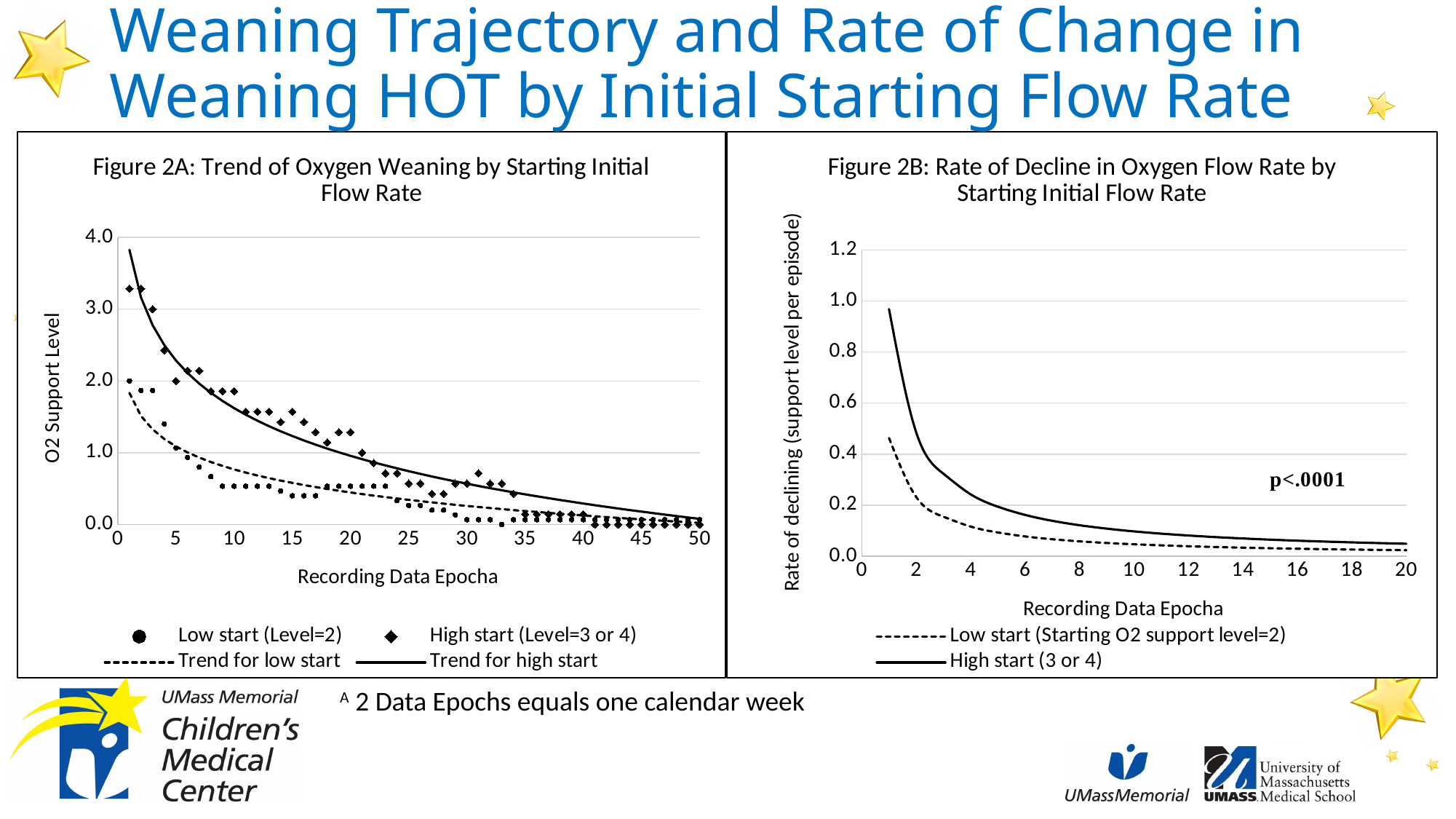
In Figure 2A, do the O2 support level values for the high start group rise or fall as the recording data epoch increases? Fall In Figure 2A, is the O2 support level for the high start group at epoch 1 greater or less than 3.0? greater How many entries does the legend of Figure 2A list? 4 In Figure 2B, is the rate of declining for the low start group at epoch 1 greater or less than 0.6? less What kind of chart is Figure 2A: Trend of Oxygen Weaning by Starting Initial Flow Rate? Scatter chart with trend lines How many series does the legend of Figure 2B list? 2 What kind of chart is Figure 2B: Rate of Decline in Oxygen Flow Rate by Starting Initial Flow Rate? Line chart In Figure 2B, does the rate of declining for the high start group rise or fall along the x axis? Fall What p-value is printed on Figure 2B? p<.0001 What is the y-axis label of Figure 2A? O2 Support Level In Figure 2B, is the rate of declining for the high start group at epoch 1 greater or less than 0.8? greater In Figure 2B, at epoch 10, which group has the higher rate of declining, the high start or the low start group? High start (3 or 4)